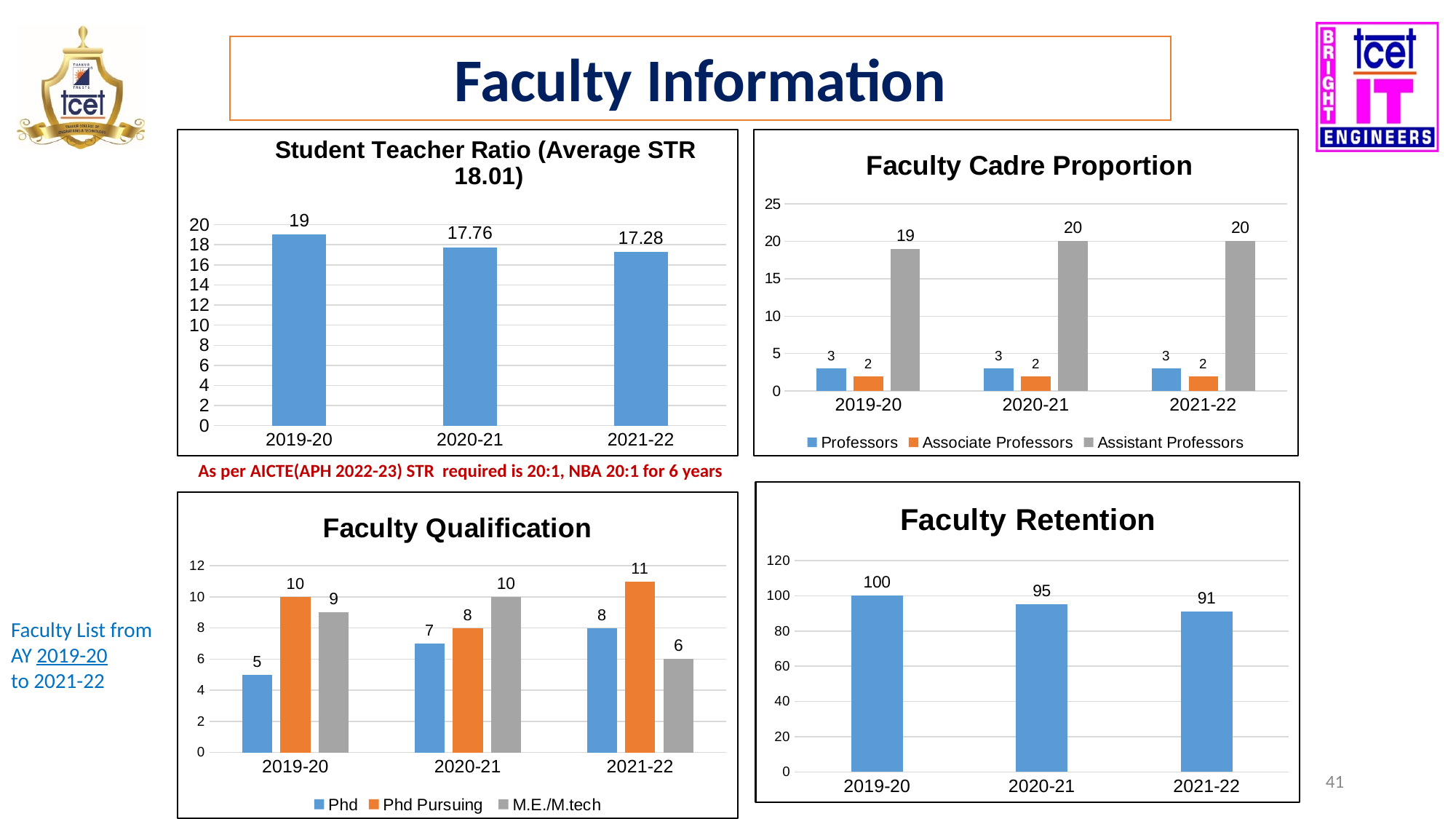
In the Faculty Cadre Proportion chart, how many series does the legend list? 3 In the Faculty Qualification chart, which series has the lowest value in 2019-20? Phd In the Student Teacher Ratio chart, which year has the highest value? 2019-20 In the Faculty Cadre Proportion chart, what is the difference between Assistant Professors and Professors in 2021-22? 17 What type of chart is the Faculty Retention chart? bar chart In the Faculty Qualification chart, what is the Phd Pursuing value for 2021-22? 11 In the Faculty Retention chart, what is the value for 2021-22? 91 In the Faculty Qualification chart, is the M.E./M.tech value for 2021-22 larger or smaller than the Phd value for 2021-22? smaller In the Faculty Retention chart, what is the difference between the 2019-20 and 2020-21 values? 5 In the Student Teacher Ratio chart, do the values rise or fall from 2019-20 to 2021-22? fall In the Faculty Cadre Proportion chart, how many Assistant Professors are shown for 2019-20? 19 In the Student Teacher Ratio chart, what is the value for 2020-21? 17.76